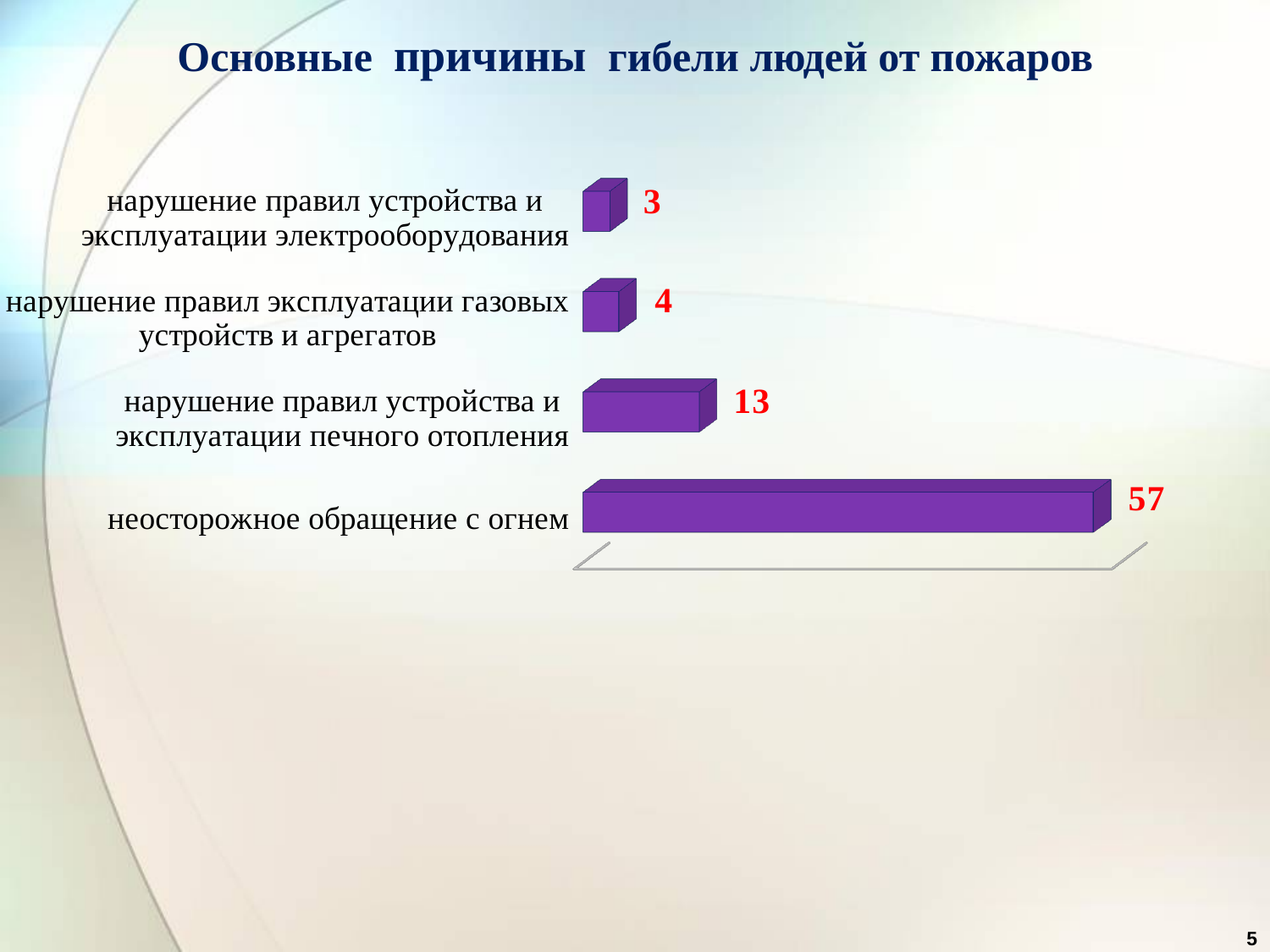
What is the value for «нарушение правил эксплуатации газовых устройств и агрегатов»? 4 Which category has the highest value? неосторожное обращение с огнем What is the value for «нарушение правил устройства и эксплуатации электрооборудования»? 3 What is the value for «неосторожное обращение с огнем»? 57 Which is larger: the value for «нарушение правил устройства и эксплуатации печного отопления» or for «нарушение правил эксплуатации газовых устройств и агрегатов»? нарушение правил устройства и эксплуатации печного отопления What is the difference between the values for «нарушение правил эксплуатации газовых устройств и агрегатов» and «нарушение правил устройства и эксплуатации электрооборудования»? 1 What kind of chart is shown on the slide? bar chart What is the title of the slide? Основные причины гибели людей от пожаров What is the difference between the values for «неосторожное обращение с огнем» and «нарушение правил устройства и эксплуатации печного отопления»? 44 What is the value for «нарушение правил устройства и эксплуатации печного отопления»? 13 Which category has the lowest value? нарушение правил устройства и эксплуатации электрооборудования How many categories are shown in the chart? 4